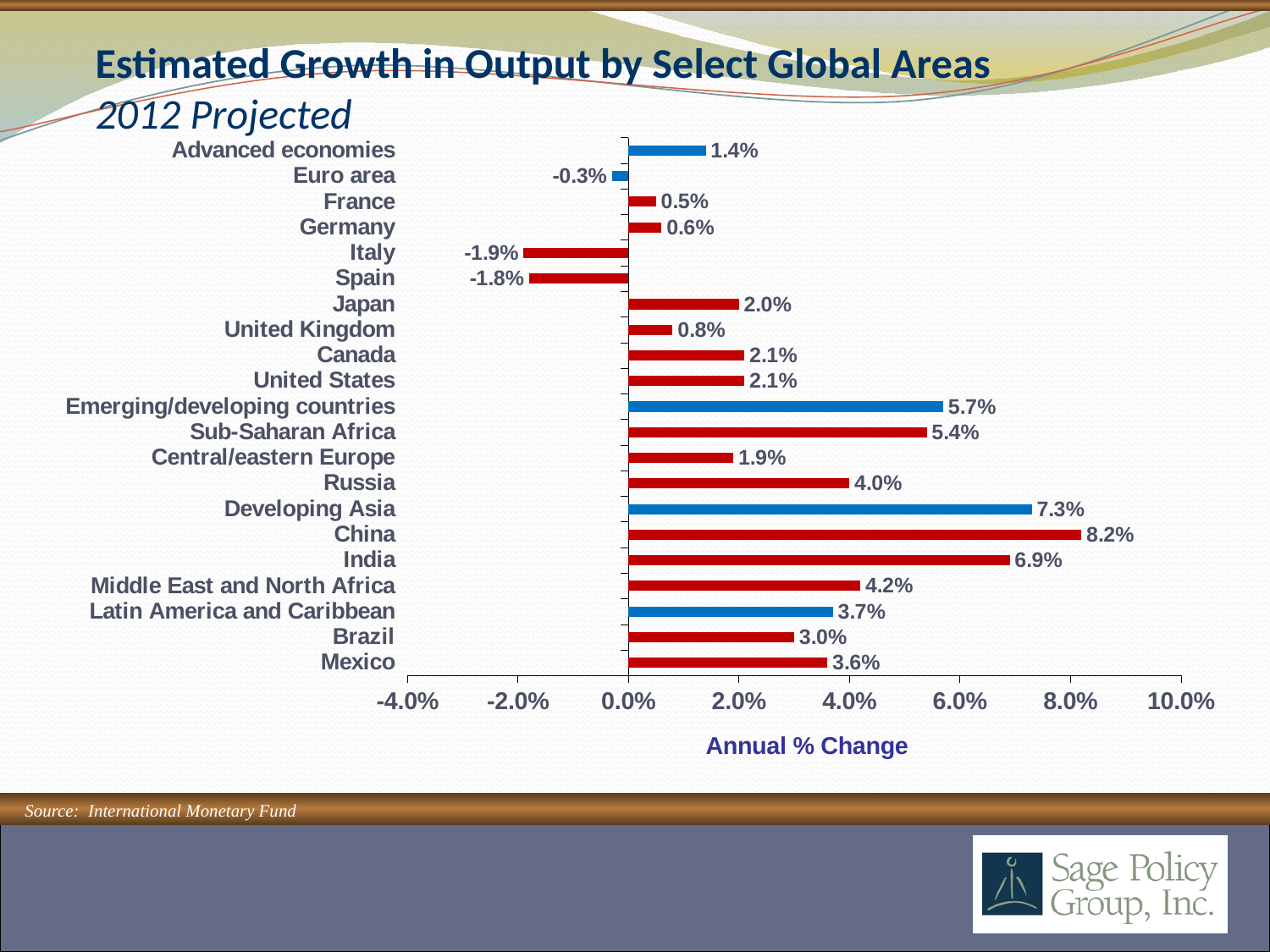
How many areas are shown in the chart? 21 What is the projected 2012 growth in output for Sub-Saharan Africa? 5.4% Which area has the lowest projected growth in output for 2012? Italy What is the difference between the projected growth for Developing Asia and Advanced economies? 5.9% What is the projected 2012 growth in output for China? 8.2% Which area has the highest projected growth in output for 2012? China What kind of chart is shown on the slide? Bar chart What is the difference between the projected growth for China and India? 1.3% What is the projected 2012 growth in output for the Euro area? -0.3% What is the label of the horizontal axis of the chart? Annual % Change Which has a higher projected growth in output, Russia or Brazil? Russia Which has a higher projected growth in output, Japan or the United Kingdom? Japan